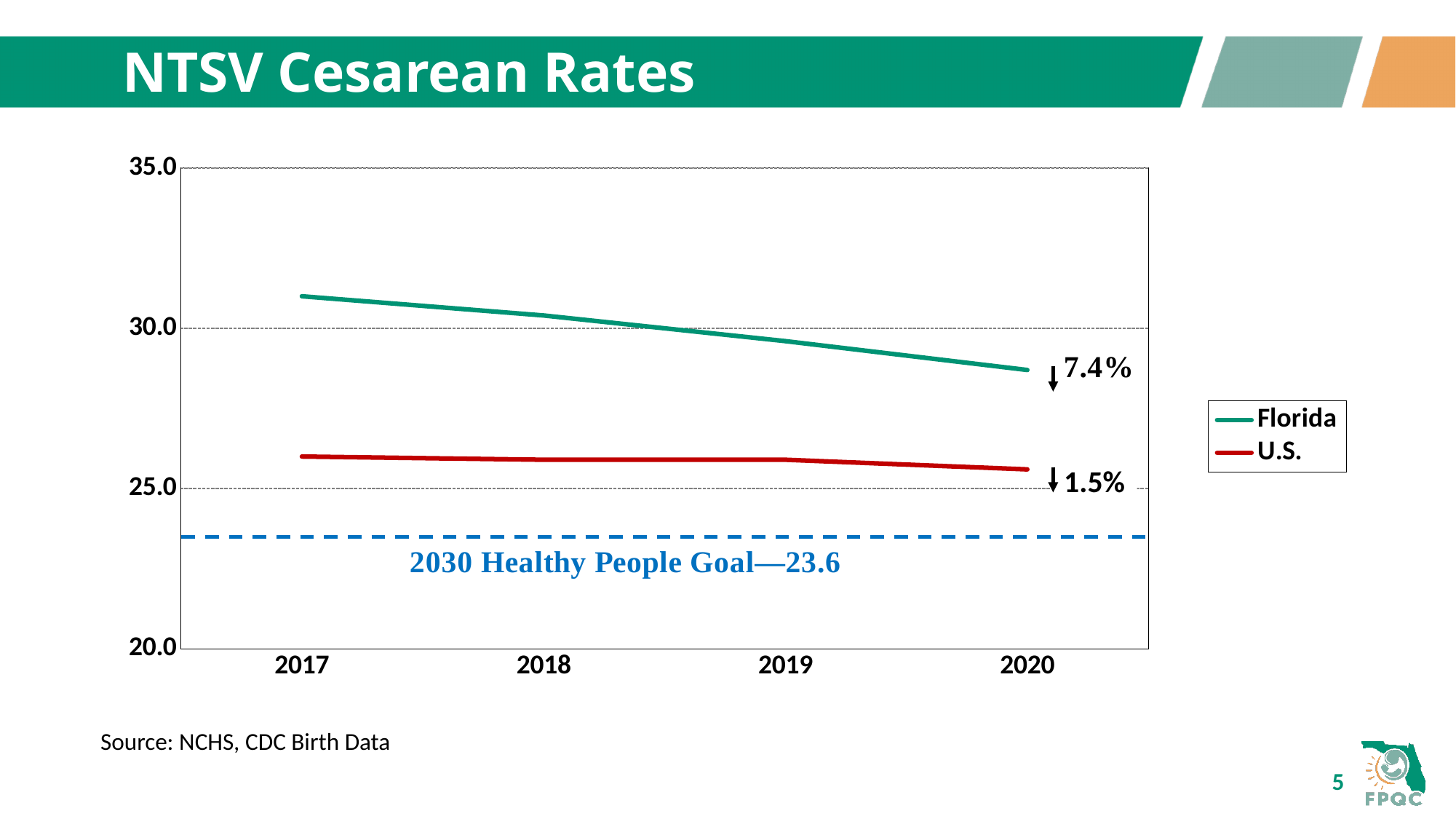
How many years are plotted along the x axis? 4 What percentage decrease is annotated next to the Florida line? 7.4% Does the Florida NTSV cesarean rate rise or fall from 2017 to 2020? fall Is the Florida value for 2017 greater or less than 30.0? greater What is the 2030 Healthy People Goal value shown by the dashed line? 23.6 Is the Florida value for 2020 greater or less than 30.0? less Is the U.S. value for 2020 greater or less than 25.0? greater What kind of chart is shown on the slide? line chart Which series has the higher NTSV cesarean rate in 2020, Florida or U.S.? Florida How many series does the legend list? 2 Does the U.S. NTSV cesarean rate rise or fall from 2017 to 2020? fall In which year is the Florida NTSV cesarean rate highest? 2017